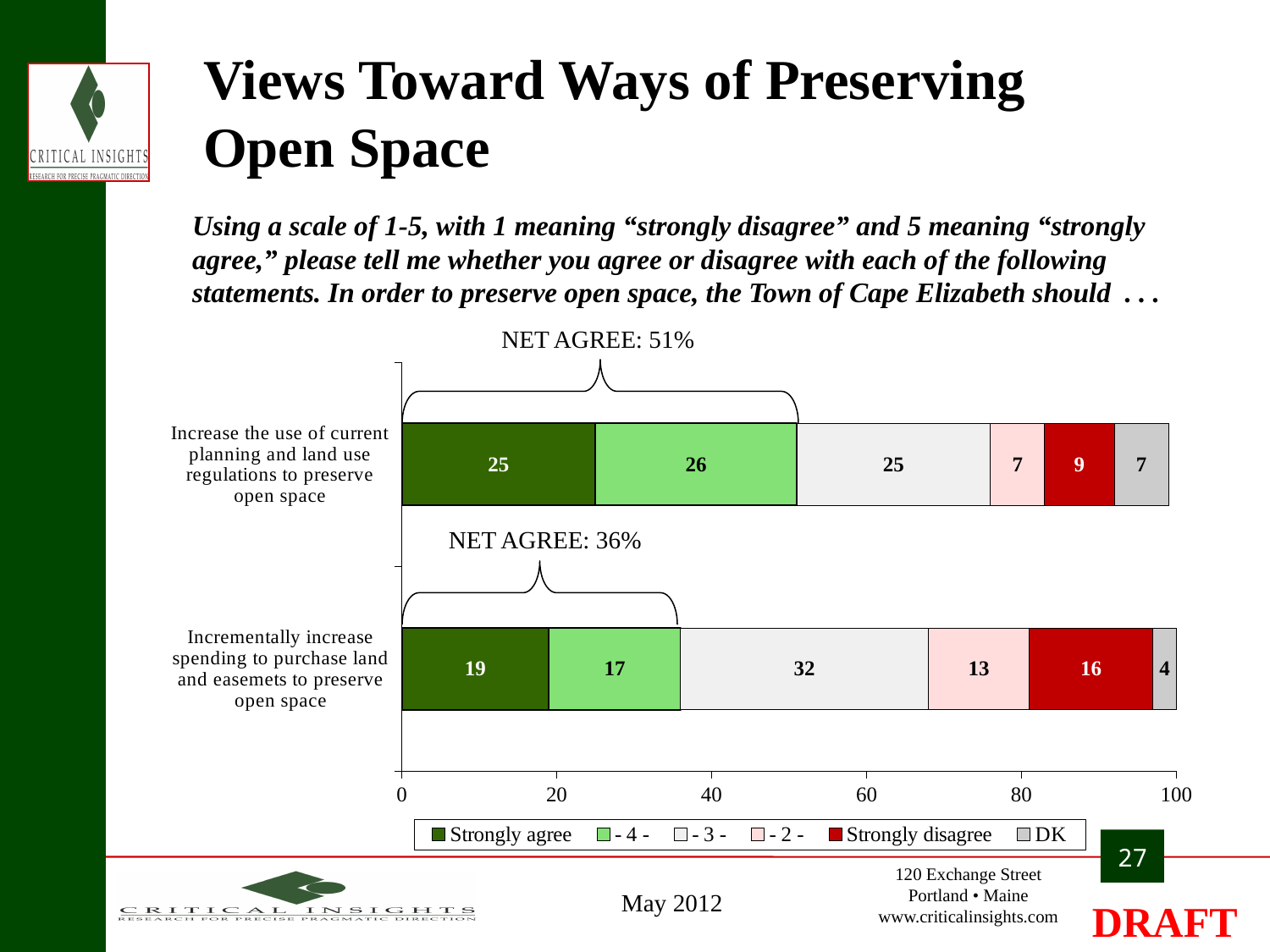
What is the '- 3 -' value for 'Incrementally increase spending to purchase land and easemets to preserve open space'? 32 What is the 'Strongly disagree' value for 'Incrementally increase spending to purchase land and easemets to preserve open space'? 16 How many series does the legend list? 6 What is the DK value for 'Increase the use of current planning and land use regulations to preserve open space'? 7 What is the 'Strongly agree' value for 'Increase the use of current planning and land use regulations to preserve open space'? 25 What kind of chart is shown on the slide? Stacked bar chart Which segment is the largest in the bar for 'Incrementally increase spending to purchase land and easemets to preserve open space'? - 3 - How many statements (categories) are plotted in the chart? 2 Which statement has the higher 'Strongly agree' value? Increase the use of current planning and land use regulations to preserve open space What is the NET AGREE figure shown for 'Incrementally increase spending to purchase land and easemets to preserve open space'? 36% What is the difference between the '- 4 -' values for the two statements? 9 What is the difference between the 'Strongly disagree' values for the two statements? 7